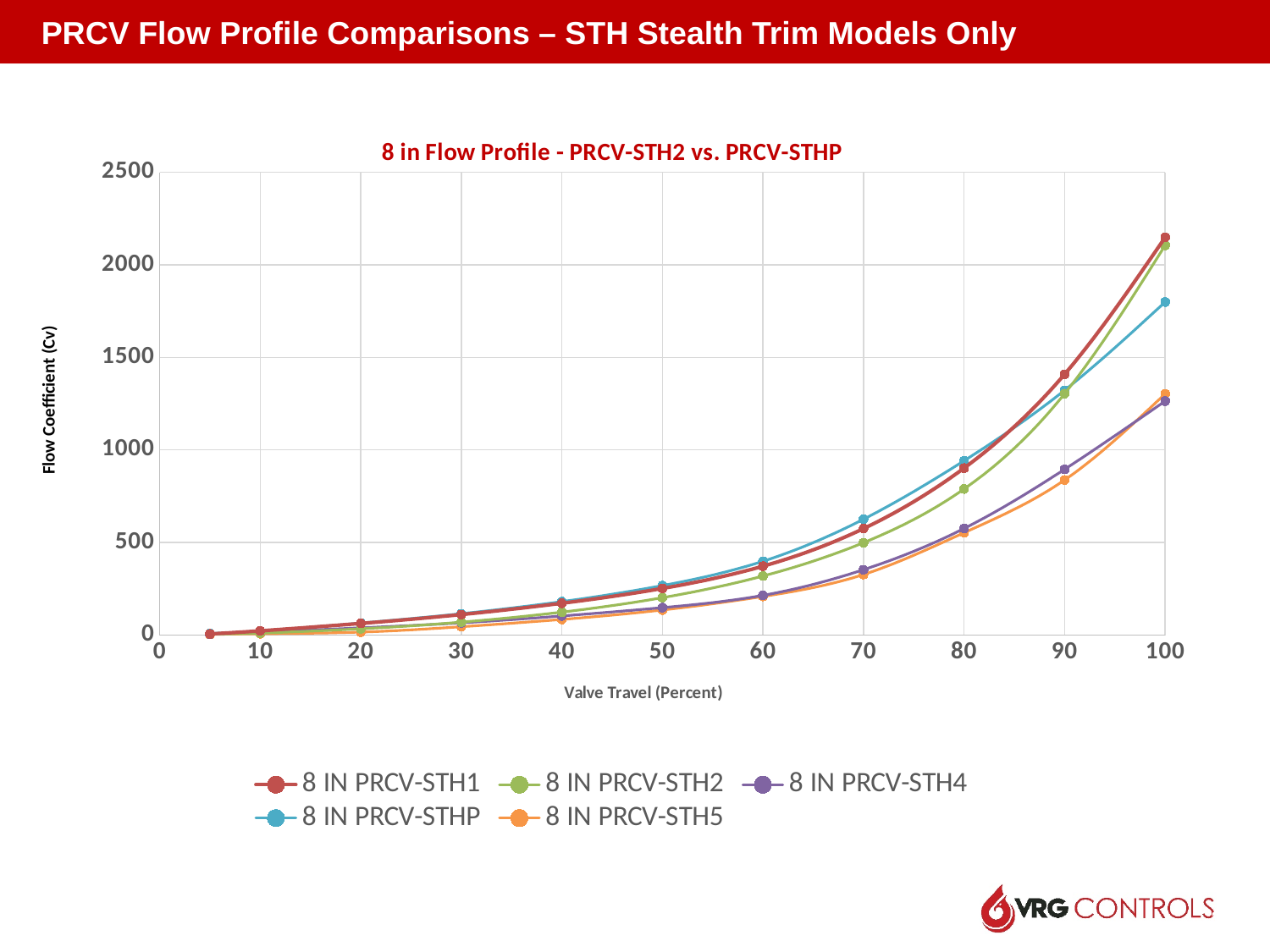
Is the value for 8 IN PRCV-STH1 at 100 percent valve travel greater or less than 2000? greater What kind of chart is shown on the slide? line chart What is the label of the vertical axis? Flow Coefficient (Cv) Is the value for 8 IN PRCV-STH4 at 70 percent valve travel greater or less than 500? less Is the value for 8 IN PRCV-STH1 at 90 percent valve travel greater or less than 1500? less At 100 percent valve travel, which is larger: 8 IN PRCV-STHP or 8 IN PRCV-STH5? 8 IN PRCV-STHP Do the flow coefficient values rise or fall as valve travel increases from 0 to 100 percent? rise How many series does the legend list? 5 What is the title of the chart? 8 in Flow Profile - PRCV-STH2 vs. PRCV-STHP